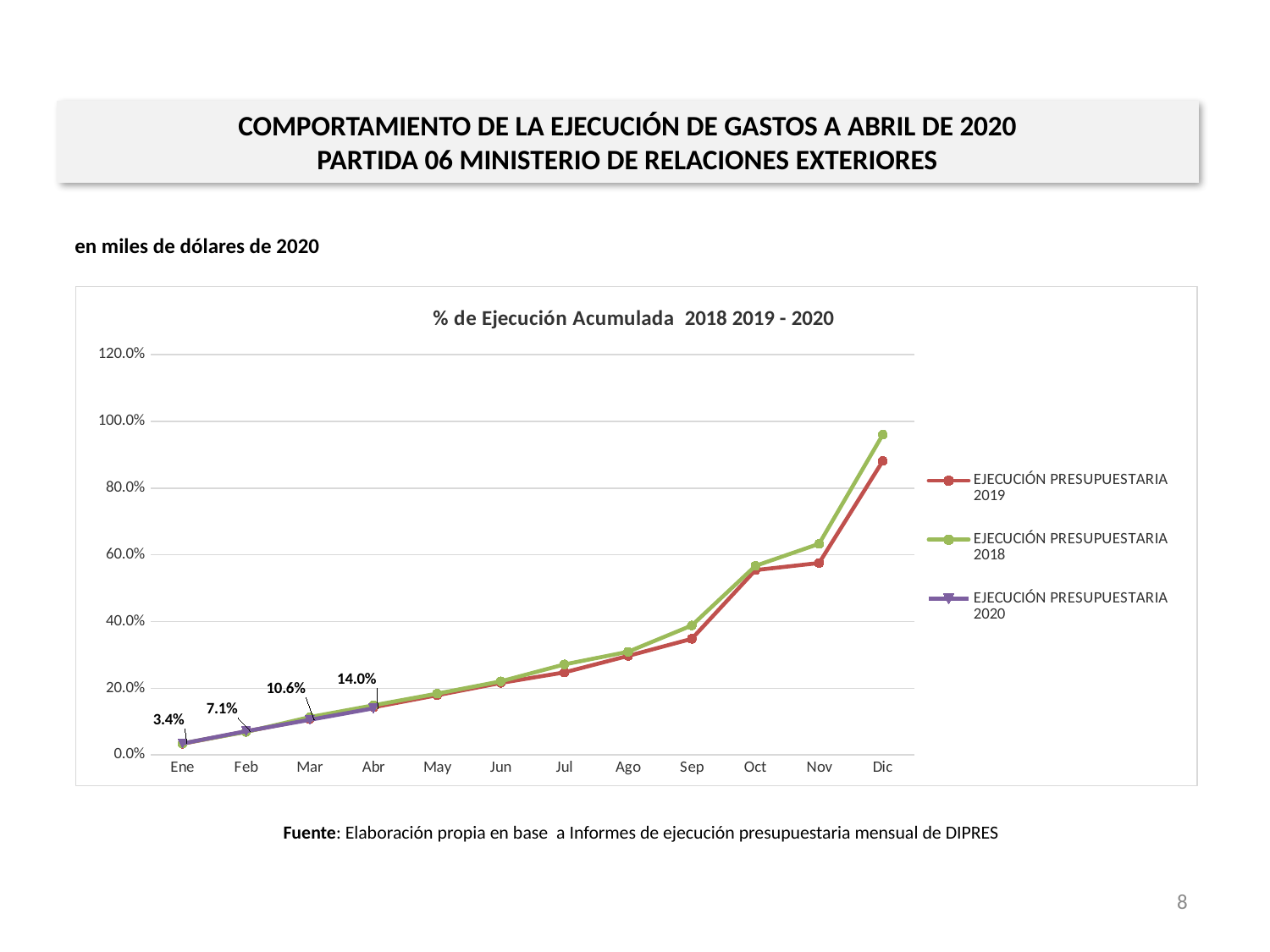
Is the value for EJECUCIÓN PRESUPUESTARIA 2018 in Dic greater or less than 80.0%? greater What is the difference between the EJECUCIÓN PRESUPUESTARIA 2020 values for Abr and Ene? 10.6% In Dic, which series is higher: EJECUCIÓN PRESUPUESTARIA 2018 or EJECUCIÓN PRESUPUESTARIA 2019? EJECUCIÓN PRESUPUESTARIA 2018 What is the title of the chart? % de Ejecución Acumulada 2018 2019 - 2020 What is the value of EJECUCIÓN PRESUPUESTARIA 2020 in Abr? 14.0% What kind of chart is shown on the slide? Line chart Do the values for EJECUCIÓN PRESUPUESTARIA 2018 rise or fall from Ene to Dic? Rise What is the value of EJECUCIÓN PRESUPUESTARIA 2020 in Mar? 10.6% What is the value of EJECUCIÓN PRESUPUESTARIA 2020 in Ene? 3.4% How many series does the legend list? 3 How many months are shown on the x axis? 12 What is the difference between the EJECUCIÓN PRESUPUESTARIA 2020 values for Feb and Ene? 3.7%